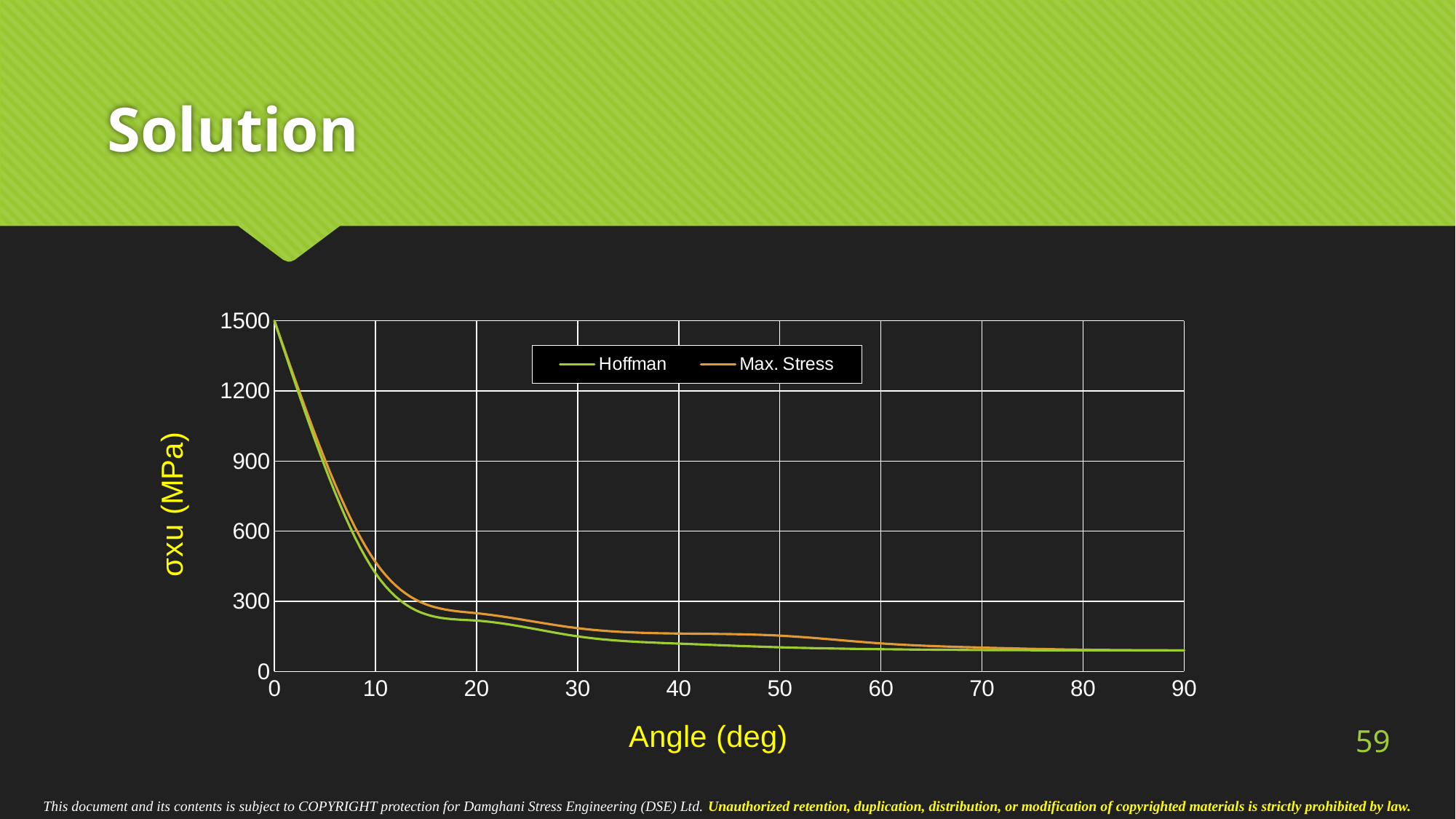
Is the Hoffman value at an angle of 30 degrees greater or less than 300? less Is the Max. Stress value at an angle of 20 degrees greater or less than 300? less What are the two series named in the legend? Hoffman and Max. Stress How many labelled tick marks are there on the x axis? 10 What kind of chart is shown on the slide? line chart How many series does the legend list? 2 Is the Hoffman value at an angle of 10 degrees greater or less than 600? less At an angle of 20 degrees, which series has the higher value, Hoffman or Max. Stress? Max. Stress At an angle of 30 degrees, which series has the higher value, Hoffman or Max. Stress? Max. Stress What is the title of the x axis? Angle (deg) Do the values of the Hoffman series rise or fall as the angle increases from 0 to 90 degrees? fall